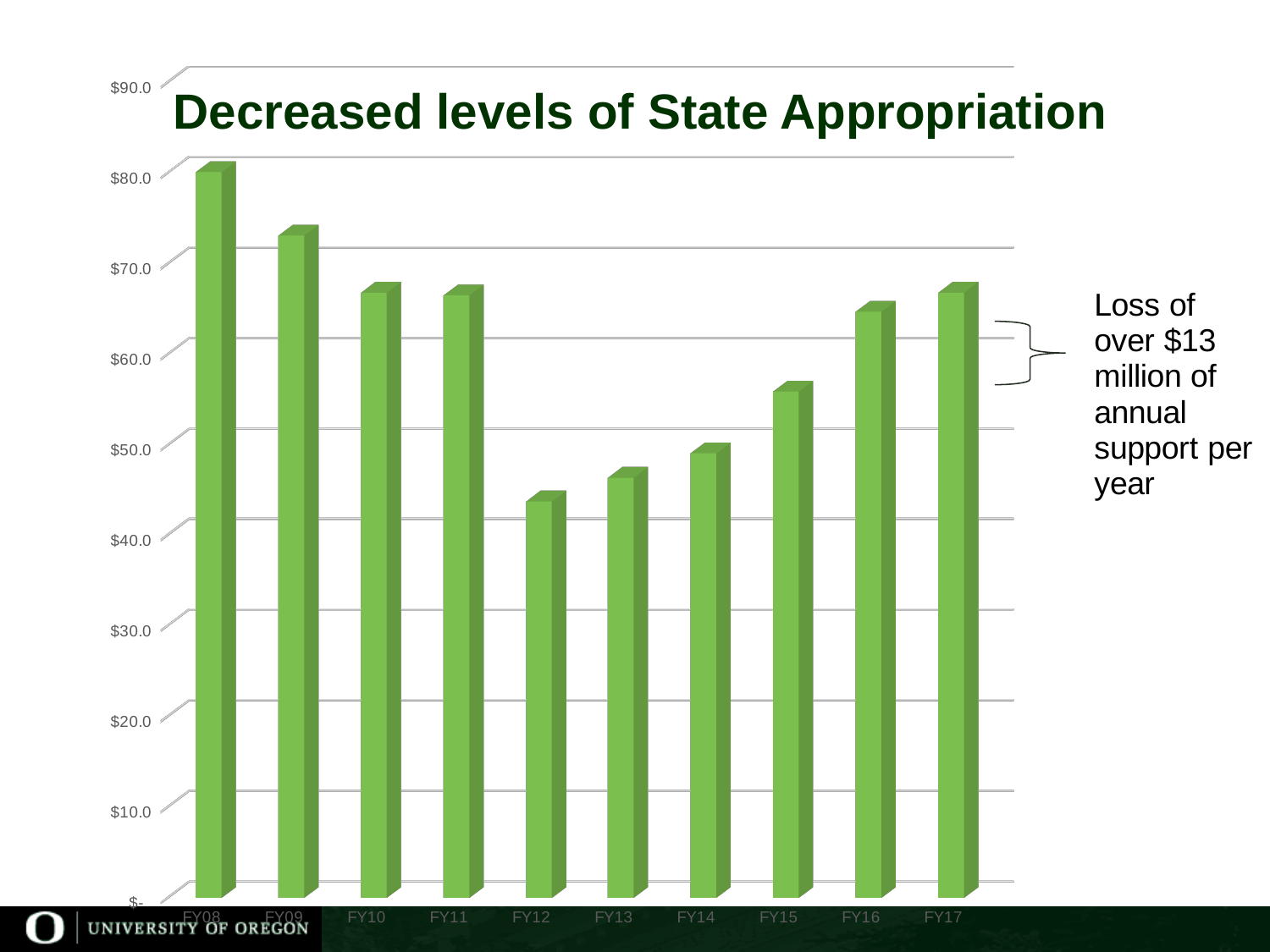
Is the value for FY08 greater or less than $70.0? greater Is the value for FY15 greater or less than $50.0? greater Which fiscal year has the lowest value? FY12 What kind of chart is shown on the slide? Bar chart Is the value for FY12 greater or less than $50.0? less Which is larger, the value for FY08 or the value for FY17? FY08 Which fiscal year has the highest value? FY08 What is the title of the chart? Decreased levels of State Appropriation How many fiscal years are plotted in the chart? 10 Do the values rise or fall from FY12 to FY17? rise Do the values rise or fall from FY08 to FY12? fall